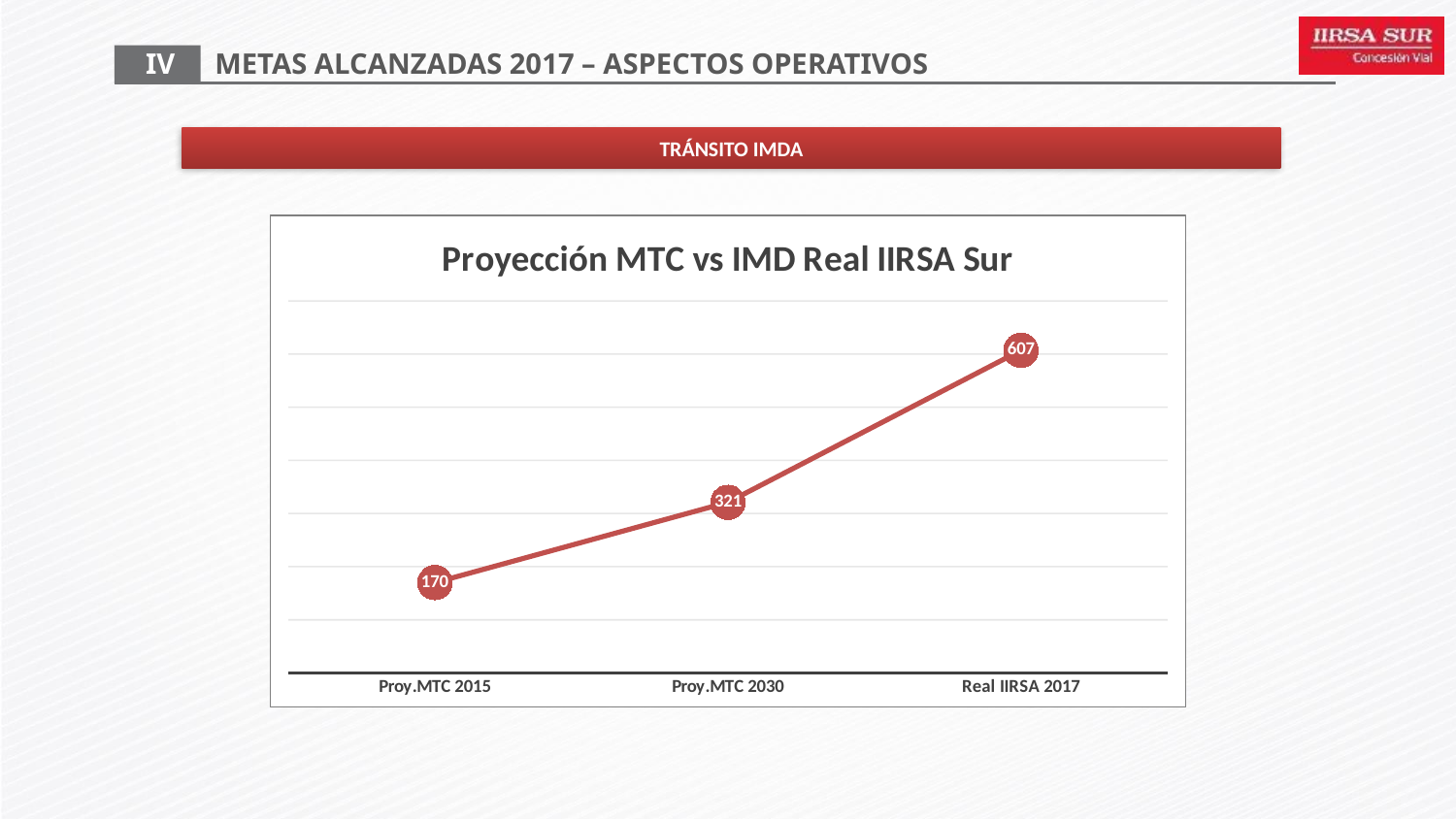
What is the title of the chart? Proyección MTC vs IMD Real IIRSA Sur What is the value for Real IIRSA 2017? 607 Do the values rise or fall from Proy.MTC 2015 to Real IIRSA 2017? Rise What is the difference between the values for Proy.MTC 2030 and Proy.MTC 2015? 151 What is the value for Proy.MTC 2015? 170 Which category has the lowest value? Proy.MTC 2015 Which is larger, the value for Proy.MTC 2030 or the value for Real IIRSA 2017? Real IIRSA 2017 How many data points are plotted on the chart? 3 What kind of chart is shown on the slide? Line chart What is the difference between the values for Real IIRSA 2017 and Proy.MTC 2030? 286 What is the value for Proy.MTC 2030? 321 Which category has the highest value? Real IIRSA 2017